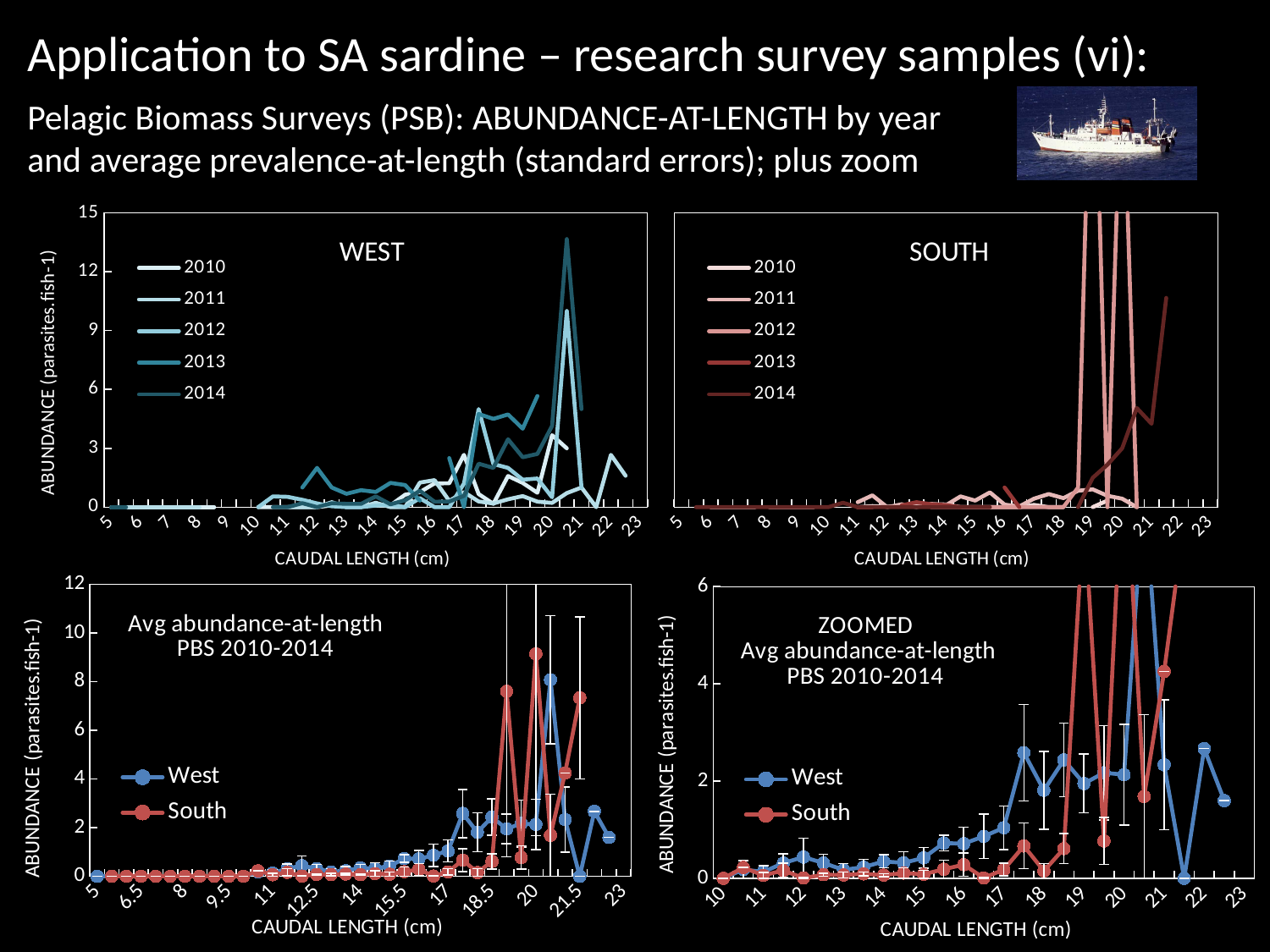
On the 'Avg abundance-at-length PBS 2010-2014' chart at the bottom left, is the highest West value greater or less than 10? less On the ZOOMED chart at the bottom right, is the West value at 22 cm greater or less than 2? greater What is the y-axis title of the ZOOMED chart at the bottom right? ABUNDANCE (parasites.fish-1) On the 'Avg abundance-at-length PBS 2010-2014' chart at the bottom left, which series has the highest plotted point, West or South? South What kind of chart is the WEST chart at the top left of the slide? Line chart What kind of chart is the ZOOMED chart at the bottom right? Line chart How many series does the legend of the WEST chart list? 5 Which series does the legend of the SOUTH chart list? 2010, 2011, 2012, 2013, 2014 On the WEST chart, is the highest value plotted greater or less than 12? greater How many series does the legend of the 'Avg abundance-at-length PBS 2010-2014' chart at the bottom left list? 2